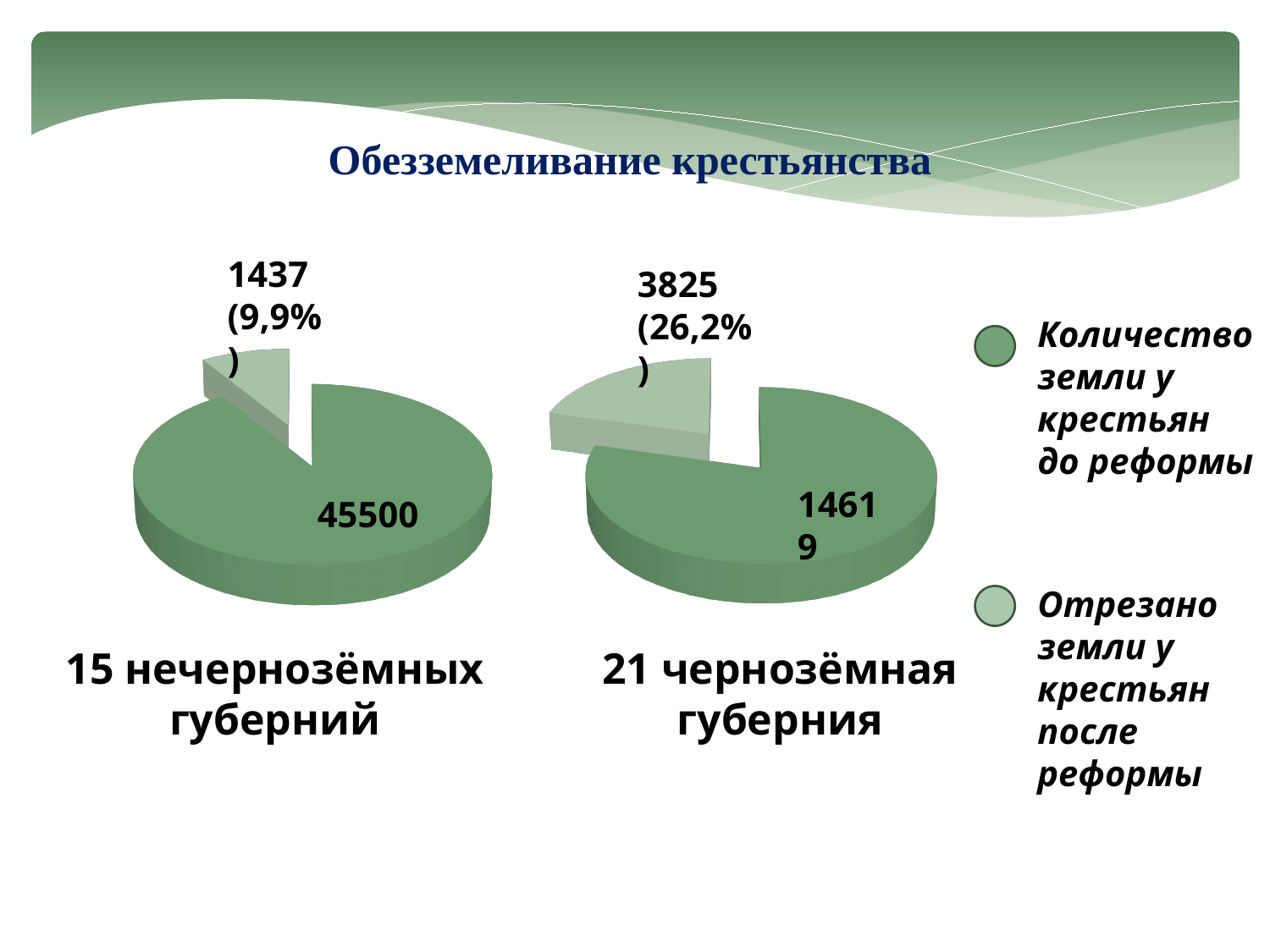
In the chart for 15 нечернозёмных губерний, what value is shown for land cut off from peasants after the reform (Отрезано земли у крестьян после реформы)? 1437 In the chart for 15 нечернозёмных губерний, which slice is larger: land before the reform or land cut off after the reform? Land before the reform (45500) What is the title of the slide containing the charts? Обезземеливание крестьянства In the chart for 15 нечернозёмных губерний, what percentage is printed next to the cut-off land slice? 9,9% In the chart for 15 нечернозёмных губерний, what value is shown for the amount of land peasants had before the reform (Количество земли у крестьян до реформы)? 45500 In the chart for 21 чернозёмная губерния, what value is shown for land cut off from peasants after the reform? 3825 In the chart for 21 чернозёмная губерния, what value is shown for the amount of land peasants had before the reform? 14619 In the chart for 21 чернозёмная губерния, what is the difference between the land before the reform and the land cut off after the reform? 10794 In the chart for 21 чернозёмная губерния, what percentage is printed next to the cut-off land slice? 26,2% What type of chart is used on this slide? Pie chart Which chart shows the larger value for land cut off after the reform: 15 нечернозёмных губерний or 21 чернозёмная губерния? 21 чернозёмная губерния How many entries does the legend list? 2